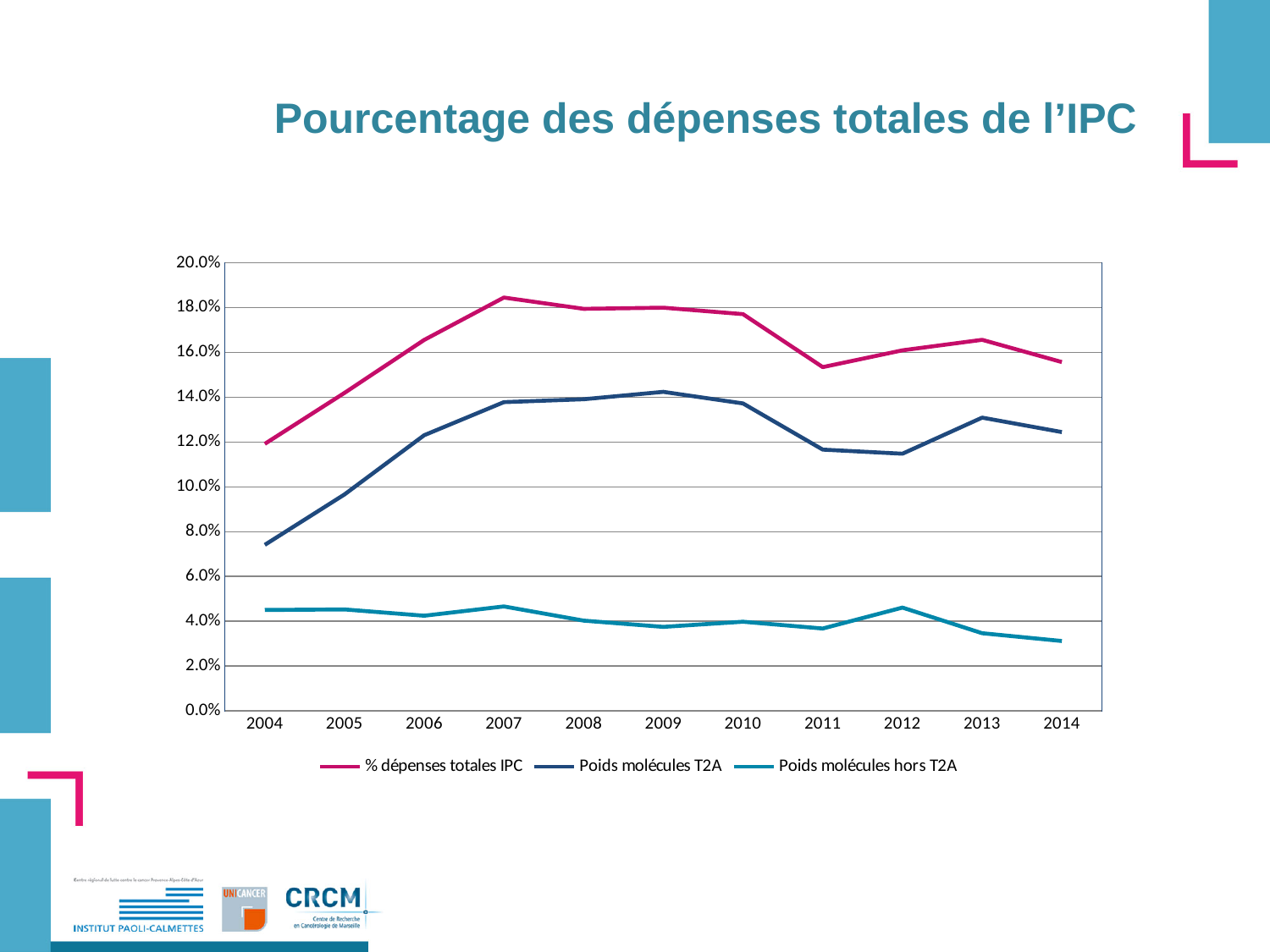
In which year is the value for % dépenses totales IPC lowest? 2004 In which year is the value for % dépenses totales IPC highest? 2007 Is the value for Poids molécules T2A in 2004 greater or less than 8.0%? less What is the title of the chart? Pourcentage des dépenses totales de l’IPC How many years are shown on the x axis? 11 What kind of chart is shown on the slide? line chart Is the value for Poids molécules hors T2A in 2014 greater or less than 4.0%? less Is the value for % dépenses totales IPC in 2007 greater or less than 18.0%? greater In which year is the value for Poids molécules T2A lowest? 2004 Which series is drawn in pink? % dépenses totales IPC How many series does the legend list? 3 Does the value for % dépenses totales IPC rise or fall from 2004 to 2007? rise